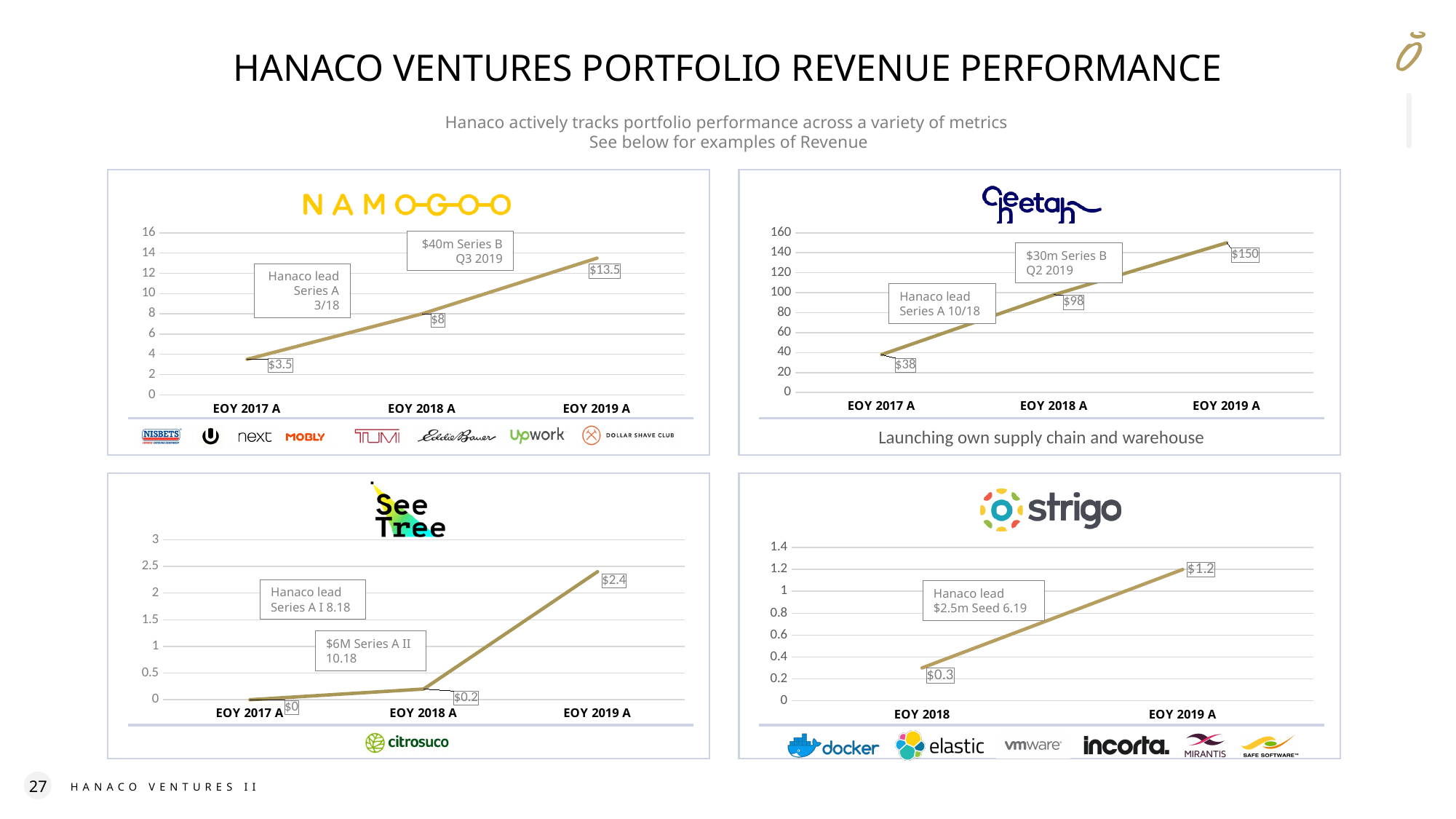
On the Cheetah chart, what is the difference between the EOY 2018 A and EOY 2017 A values? $60 On the SeeTree chart, which category has the highest value? EOY 2019 A On the SeeTree chart, what is the value for EOY 2018 A? $0.2 On the Cheetah chart, what is the value for EOY 2019 A? $150 On the Strigo chart, what is the value for EOY 2018? $0.3 What kind of chart is the Namogoo chart? Line chart On the Strigo chart, is the value for EOY 2019 A greater or less than 1? greater On the Cheetah chart, do the values rise or fall from EOY 2017 A to EOY 2019 A? Rise On the Namogoo chart, what is the value for EOY 2018 A? $8 On the Cheetah chart, which category has the lowest value? EOY 2017 A On the Strigo chart, how many data points are plotted? 2 On the Namogoo chart, what is the difference between the EOY 2019 A and EOY 2017 A values? $10